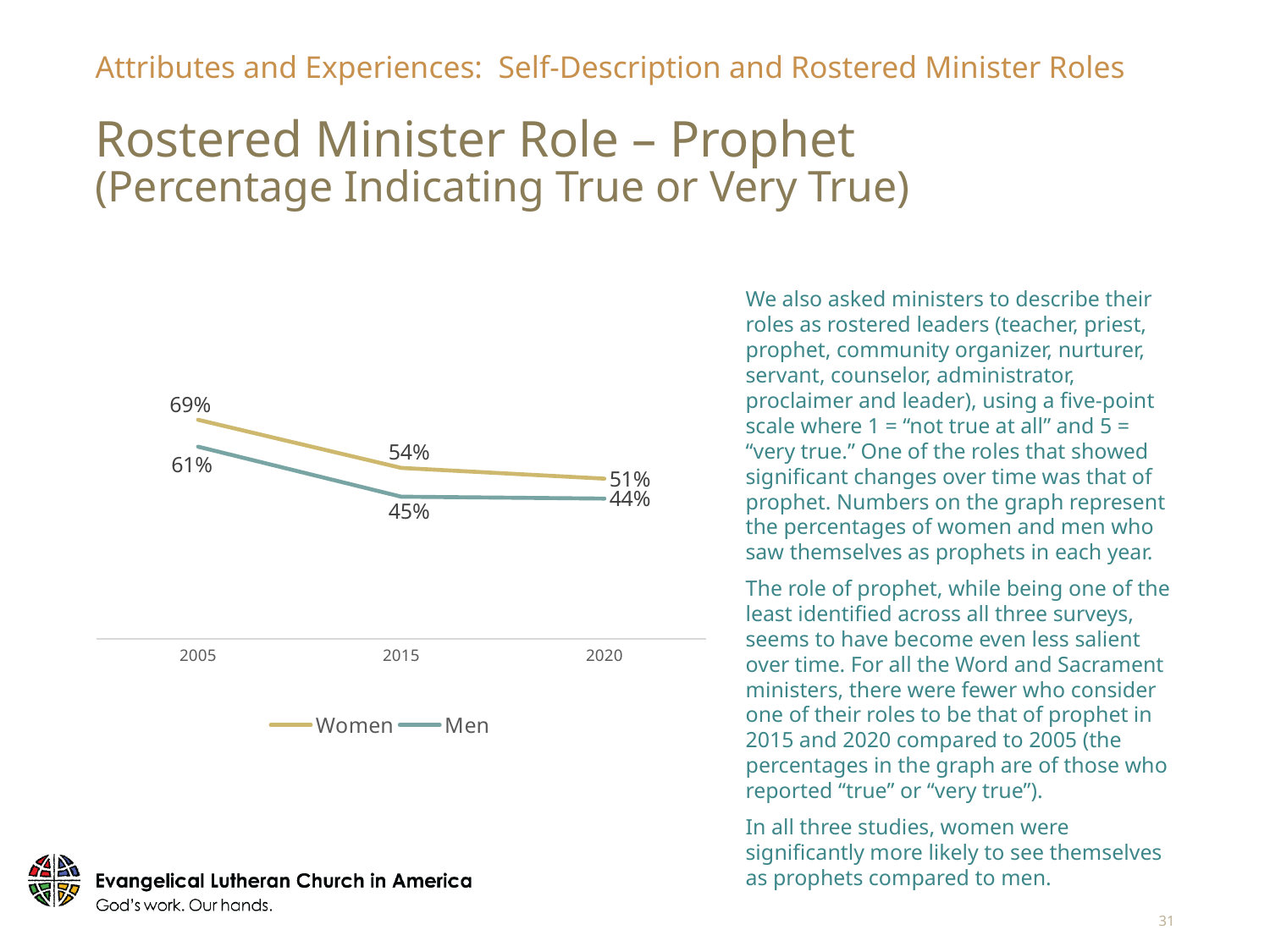
What kind of chart is shown on the slide? Line chart How many years are shown on the x axis? 3 Which series has the larger value in 2015, Women or Men? Women In which year was the value for Women lowest? 2020 What is the difference between the Women and Men values in 2005? 8% What is the value for Men in 2020? 44% How many series does the legend list? 2 What is the value for Women in 2020? 51% By how much did the Women value fall from 2005 to 2015? 15% What percentage of men indicated the prophet role was true or very true in 2015? 45% In which year was the value for Men highest? 2005 What percentage of women indicated the prophet role was true or very true in 2005? 69%